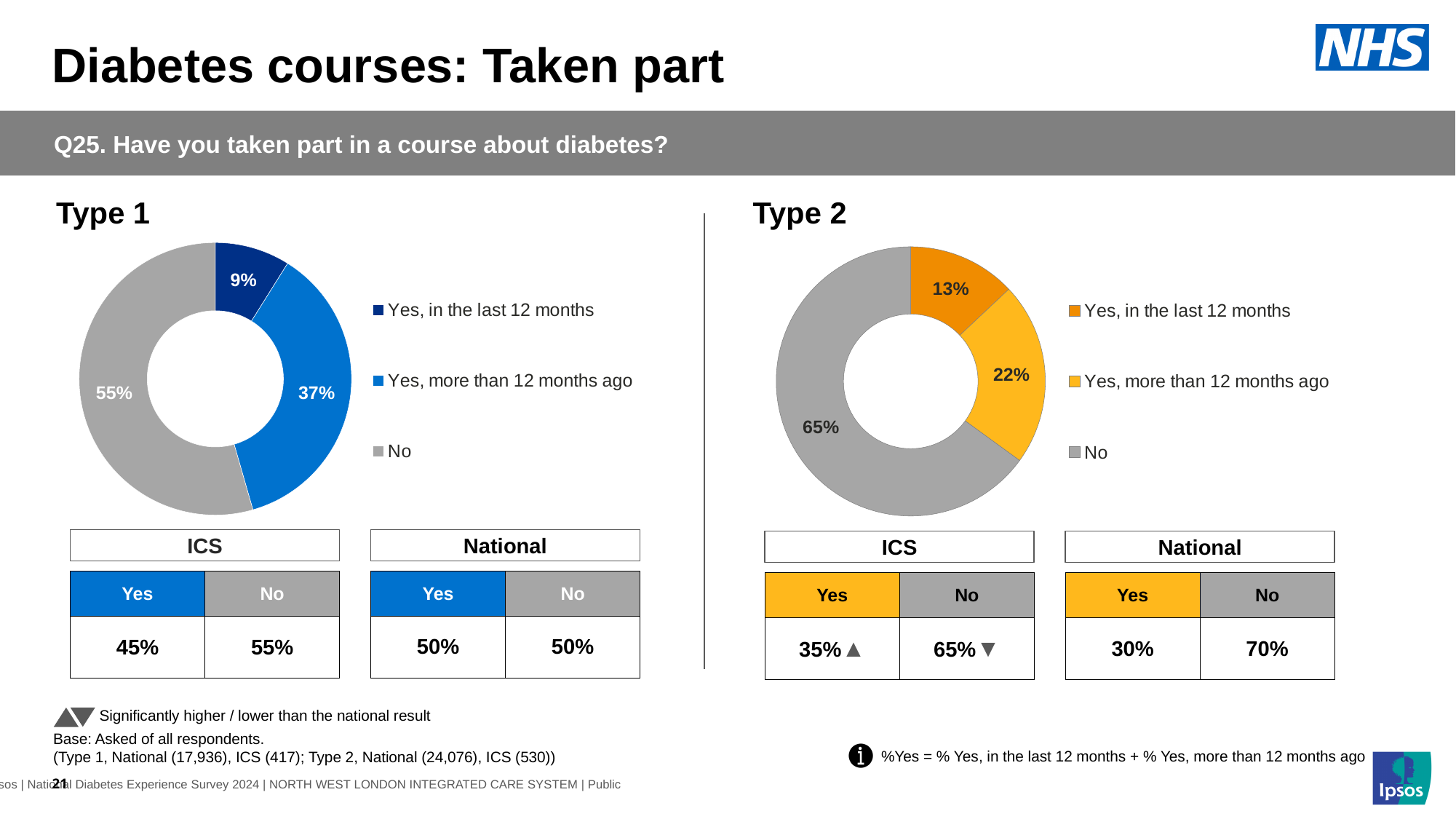
In the Type 2 chart, what is the combined share of the two 'Yes' categories? 35% Which is larger: the 'Yes, in the last 12 months' share in the Type 1 chart or in the Type 2 chart? Type 2 In the Type 2 chart, what colour represents 'Yes, more than 12 months ago'? Yellow How many categories does the legend of the Type 2 chart list? 3 In the Type 1 chart, what percentage of respondents answered 'No'? 55% In the Type 2 chart, what percentage of respondents answered 'Yes, in the last 12 months'? 13% In the Type 2 chart, what is the difference between the 'No' share and the 'Yes, more than 12 months ago' share? 43 percentage points What kind of chart is used for Type 1? Doughnut chart In the Type 1 chart, which category has the smallest share? Yes, in the last 12 months In the Type 1 chart, what percentage answered 'Yes, more than 12 months ago'? 37% In the Type 2 chart, which category has the largest share? No In the Type 1 chart, what colour represents 'No'? Grey